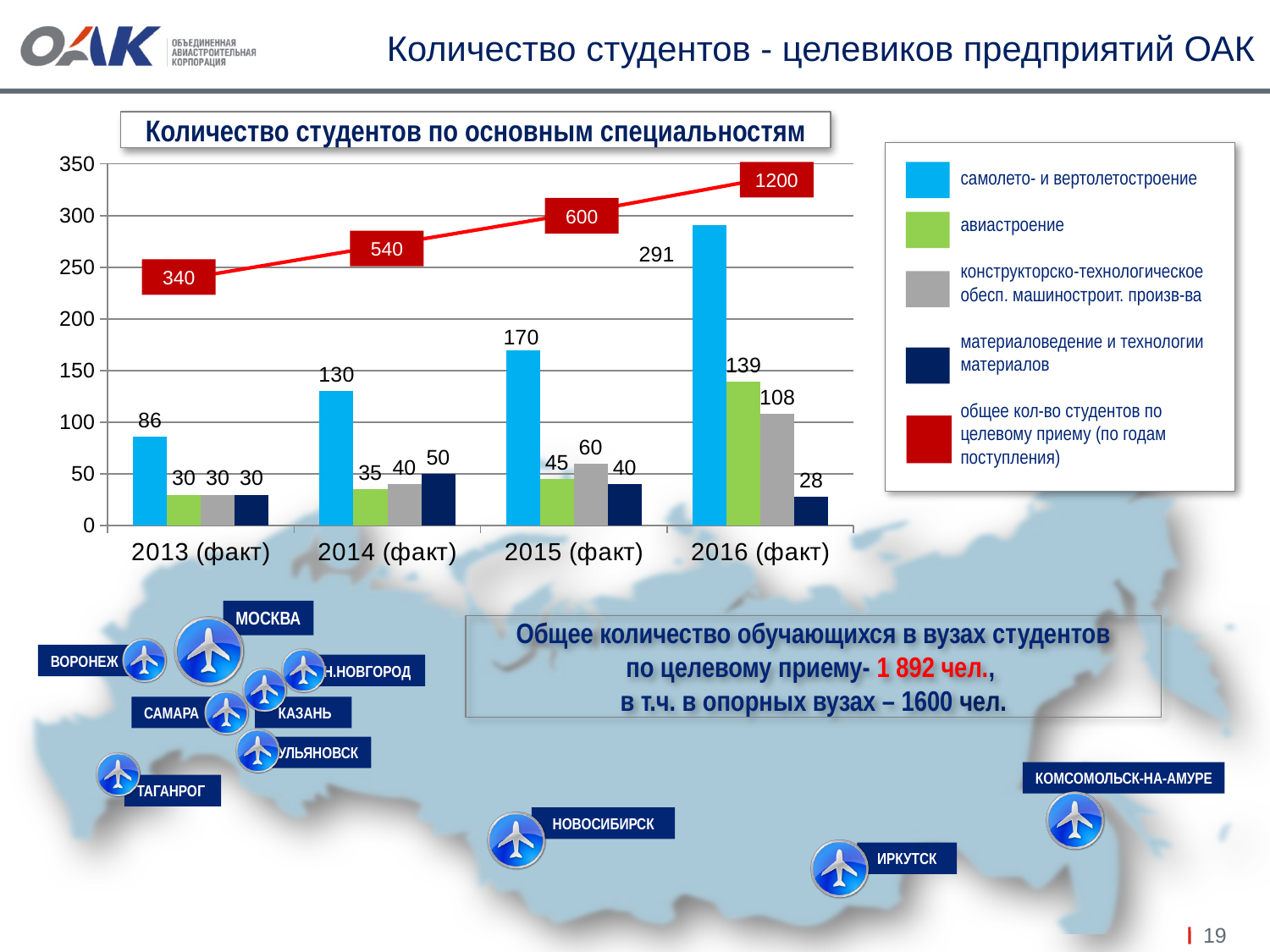
What is the value for самолето- и вертолетостроение in 2016 (факт)? 291 How many year categories are shown on the x axis? 4 What is the value for материаловедение и технологии материалов in 2016 (факт)? 28 In which year is the value for конструкторско-технологическое обесп. машиностроит. произв-ва the lowest? 2013 (факт) What is the difference between the самолето- и вертолетостроение values for 2016 (факт) and 2015 (факт)? 121 Which is larger in 2014 (факт): the value for авиастроение or for материаловедение и технологии материалов? материаловедение и технологии материалов What kind of chart is used for the specialties data? bar chart with a line Does the red line (общее кол-во студентов по целевому приему) rise or fall from 2013 to 2016? rise What is the value for авиастроение in 2015 (факт)? 45 How many series does the legend list? 5 What is the value of the red line (общее кол-во студентов по целевому приему) for 2014 (факт)? 540 In which year is the value for самолето- и вертолетостроение the highest? 2016 (факт)